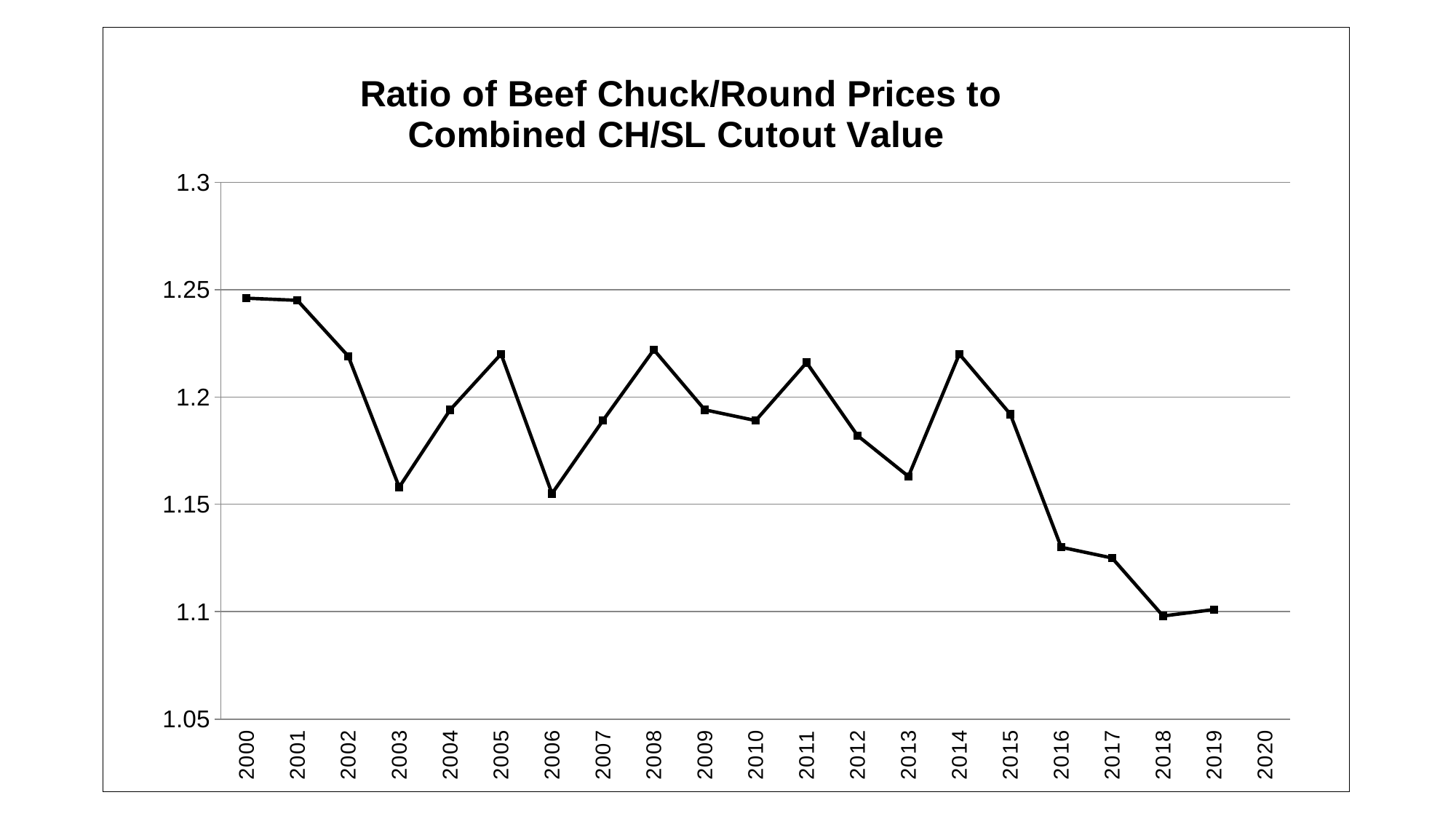
Is the value for 2003 greater or less than 1.2? less Is the value for 2016 greater or less than 1.15? less What kind of chart is shown on the slide? line chart Overall, does the ratio rise or fall from 2000 to 2019? fall Which year has the larger value, 2003 or 2005? 2005 Is the value for 2000 greater or less than 1.2? greater Which year has the larger value, 2000 or 2018? 2000 Which year has the larger value, 2014 or 2016? 2014 What is the title of the chart? Ratio of Beef Chuck/Round Prices to Combined CH/SL Cutout Value How many years have a plotted data point on the chart? 20